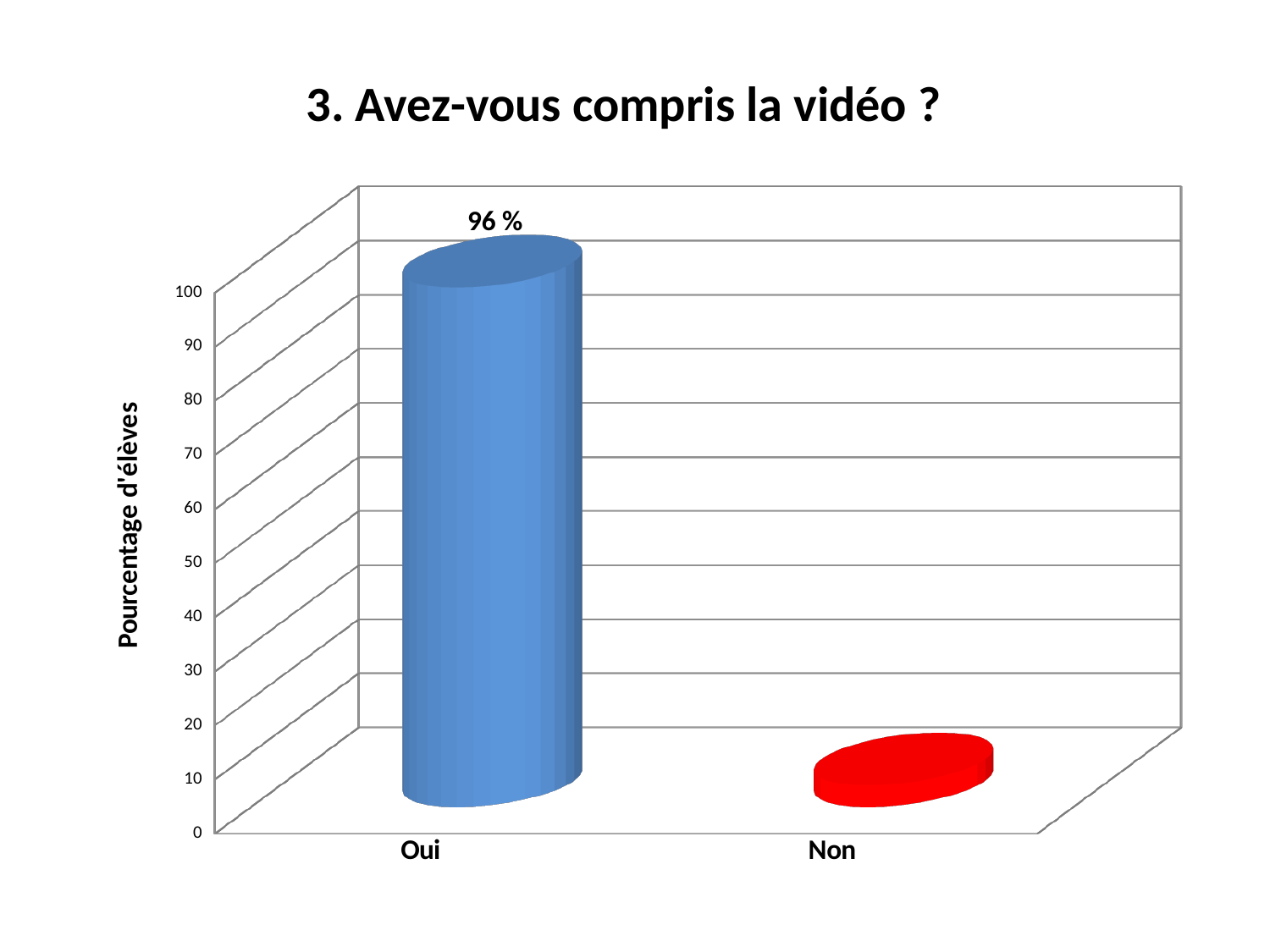
What is the title of the chart? 3. Avez-vous compris la vidéo ? Which category has the highest value? Oui Is the value for "Oui" greater or less than 90? greater Which category has the lowest value? Non What is the value shown for "Oui"? 96 % Is the value for "Non" greater or less than 10? less How many categories are shown on the x axis? 2 What kind of chart is shown on the slide? Bar chart What is the label of the vertical axis? Pourcentage d'élèves Which is larger, the value for "Oui" or the value for "Non"? Oui